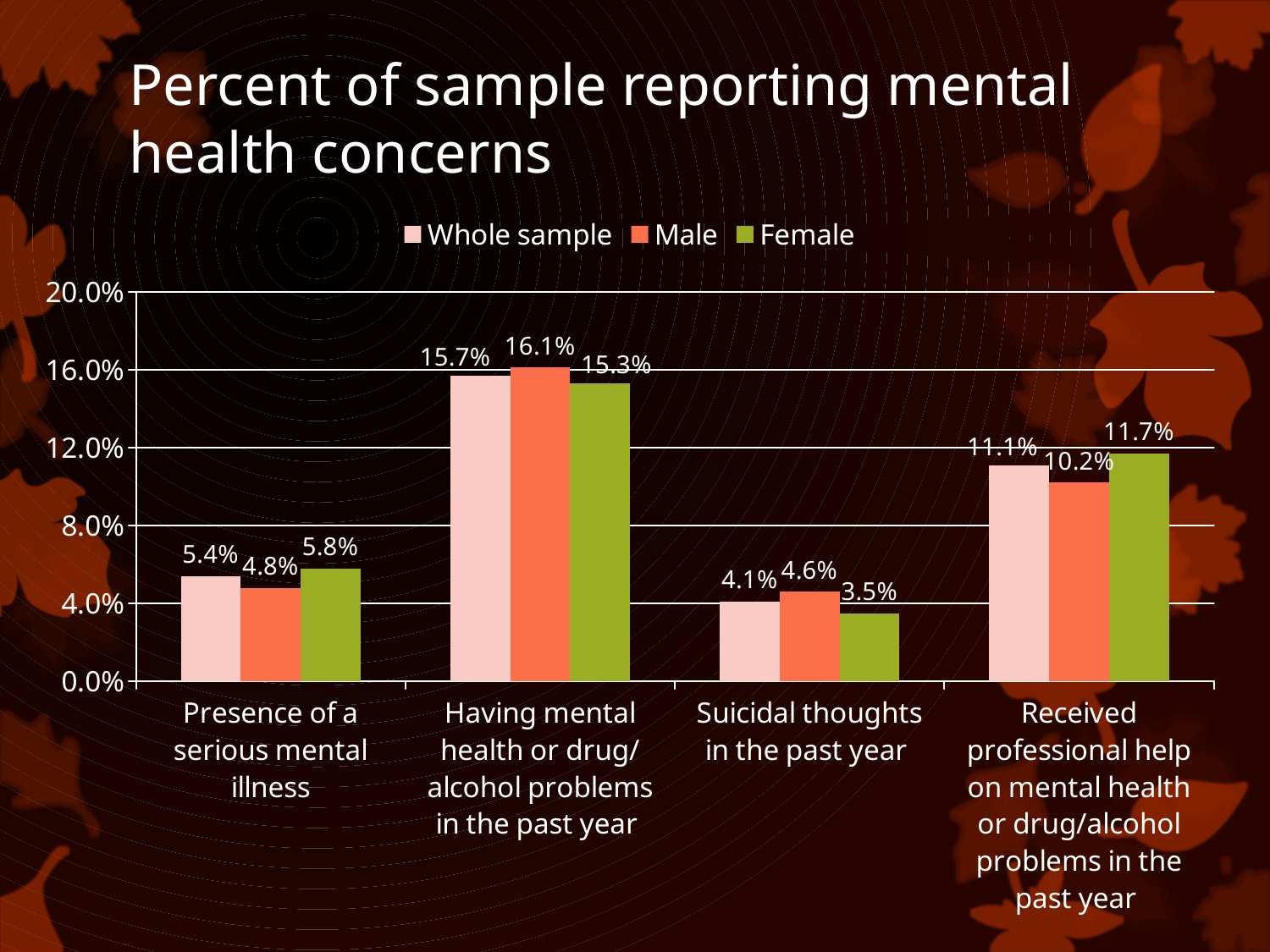
What is the Male value for 'Received professional help on mental health or drug/alcohol problems in the past year'? 10.2% How many categories are shown on the x axis? 4 Which category has the lowest Female value? Suicidal thoughts in the past year Which is larger for 'Received professional help on mental health or drug/alcohol problems in the past year': the Male value or the Female value? Female What is the difference between the Male and Female values for 'Suicidal thoughts in the past year'? 1.1% How many series does the legend list? 3 What is the Whole sample value for 'Suicidal thoughts in the past year'? 4.1% What kind of chart is shown on the slide? Bar chart Which category has the highest Whole sample value? Having mental health or drug/alcohol problems in the past year What is the Female value for 'Presence of a serious mental illness'? 5.8% What is the title of the chart? Percent of sample reporting mental health concerns What is the Male value for 'Having mental health or drug/alcohol problems in the past year'? 16.1%